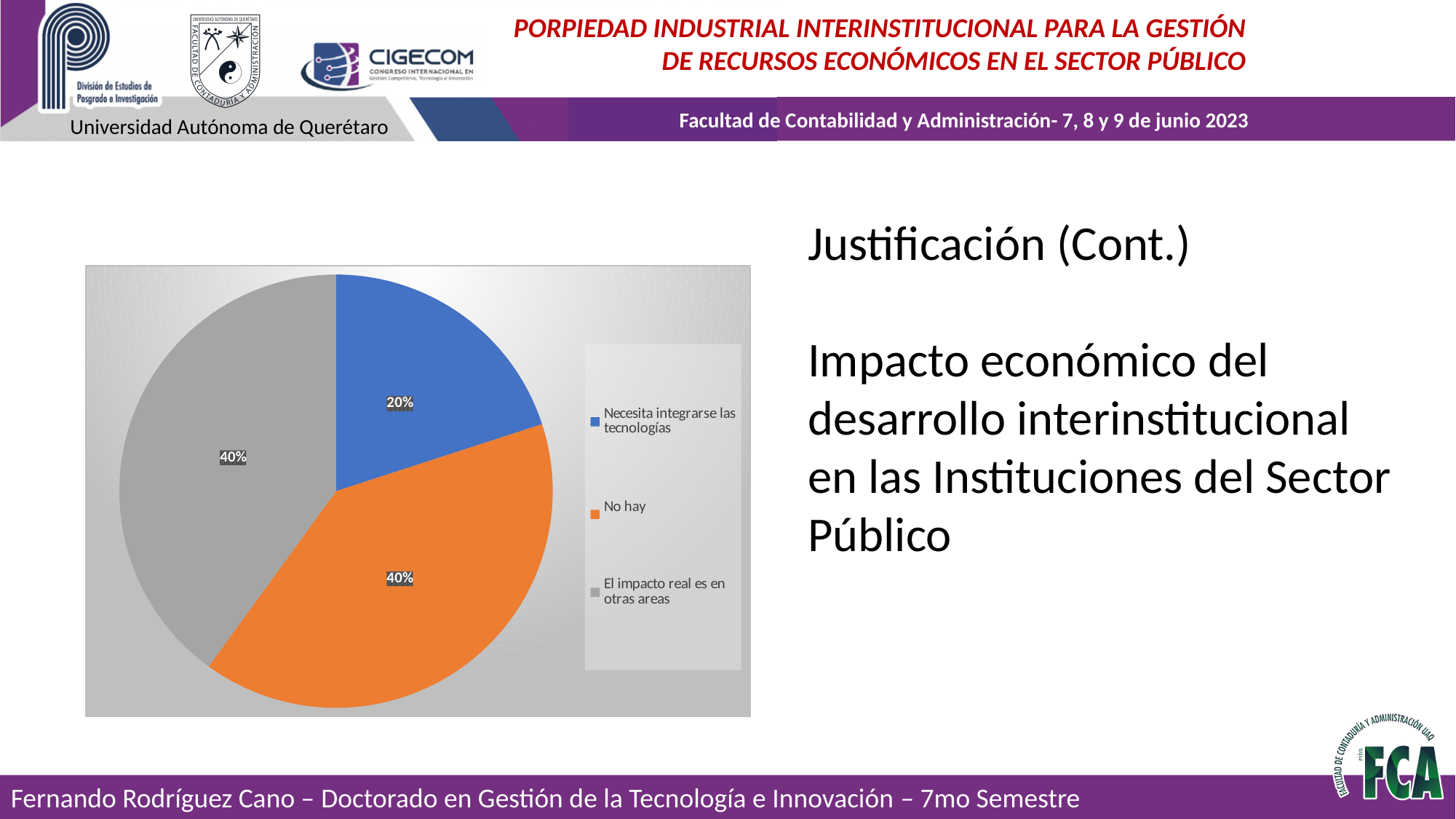
What colour is the slice for "No hay"? orange Which category has the smallest slice of the pie? Necesita integrarse las tecnologías How many slices does the pie chart have? 3 What is the combined share of "No hay" and "El impacto real es en otras areas"? 80% What share of the pie does "Necesita integrarse las tecnologías" represent? 20% How many entries does the legend list? 3 What is the difference between the share for "No hay" and the share for "Necesita integrarse las tecnologías"? 20% What share of the pie does "No hay" represent? 40% What kind of chart is shown on the slide? pie chart What share of the pie does "El impacto real es en otras areas" represent? 40% Which legend entry is shown in blue? Necesita integrarse las tecnologías Which is larger, the slice for "No hay" or the slice for "Necesita integrarse las tecnologías"? No hay